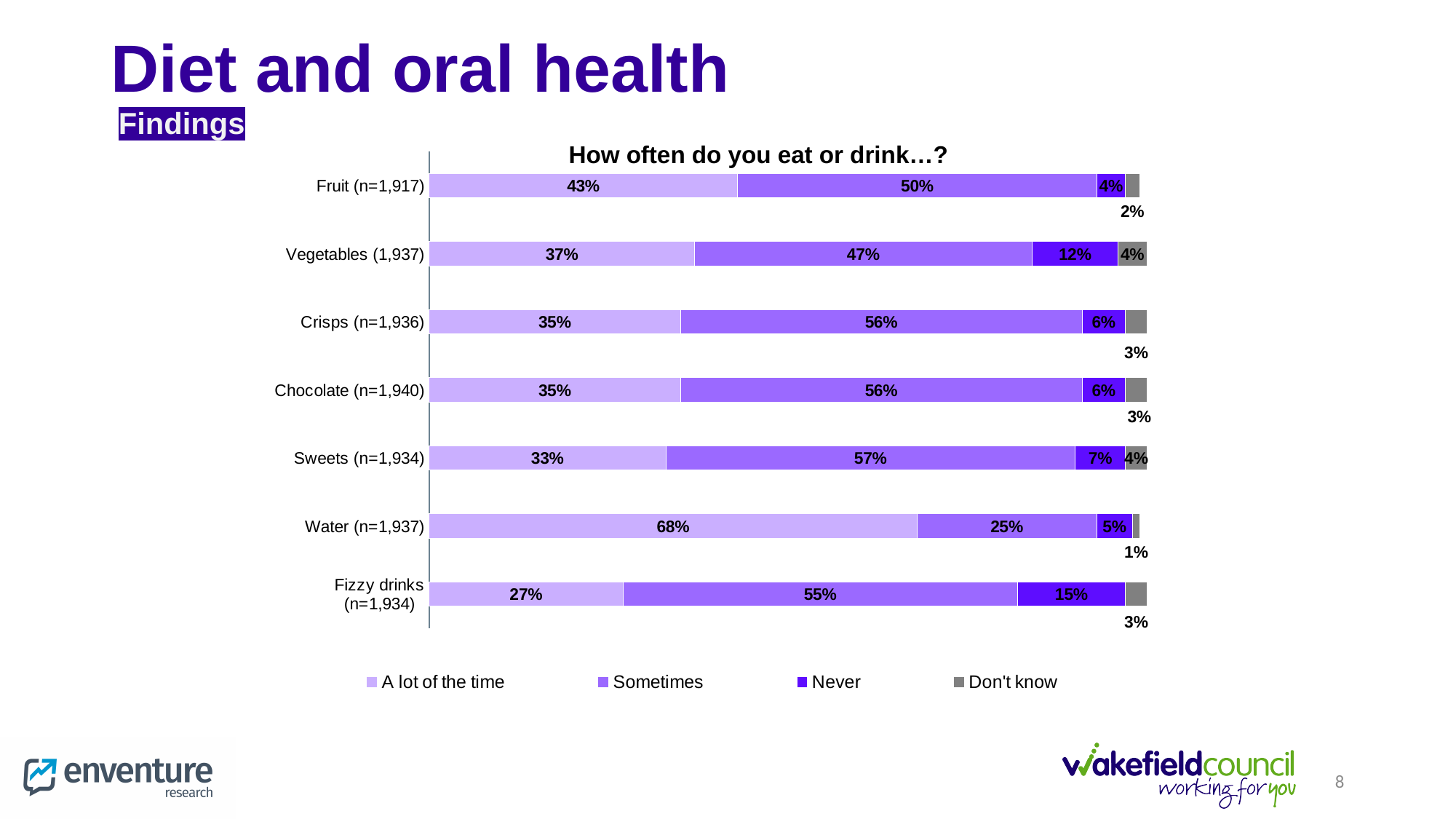
How many response categories does the legend list? 4 How many food or drink items are shown in the chart? 7 Which is larger: the 'Never' percentage for vegetables or for sweets? Vegetables Which item has the highest 'A lot of the time' percentage? Water Which item has the lowest 'A lot of the time' percentage? Fizzy drinks What percentage of respondents drink water a lot of the time? 68% Which item has the highest 'Never' percentage? Fizzy drinks What type of chart is shown on the slide? Stacked bar chart What percentage of respondents eat vegetables sometimes? 47% What is the difference between the 'A lot of the time' percentages for water and fruit? 25% What is the title of the chart? How often do you eat or drink…? What is the 'Never' value for fizzy drinks? 15%